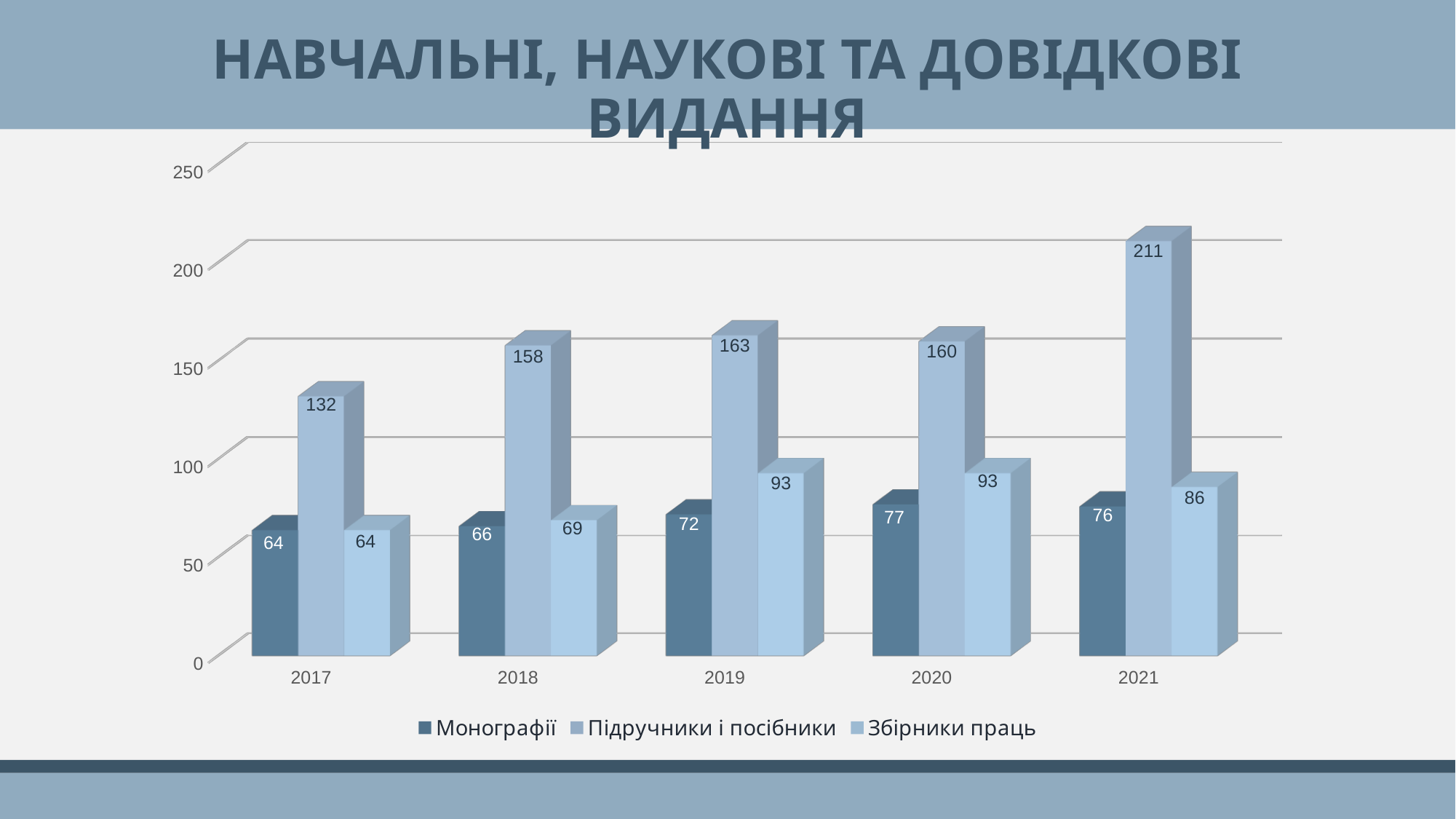
How many series does the legend list? 3 What is the title of the slide? НАВЧАЛЬНІ, НАУКОВІ ТА ДОВІДКОВІ ВИДАННЯ What is the value for Монографії in 2019? 72 Which is larger: Збірники праць in 2019 or Збірники праць in 2021? 2019 In which year is the value for Підручники і посібники lowest? 2017 What is the value for Підручники і посібники in 2021? 211 What is the difference between the Підручники і посібники values for 2021 and 2020? 51 What is the value for Збірники праць in 2018? 69 Does the value for Монографії rise or fall from 2017 to 2020? Rise In which year is the value for Підручники і посібники highest? 2021 How many years are shown on the x axis? 5 What kind of chart is shown on the slide? Bar chart